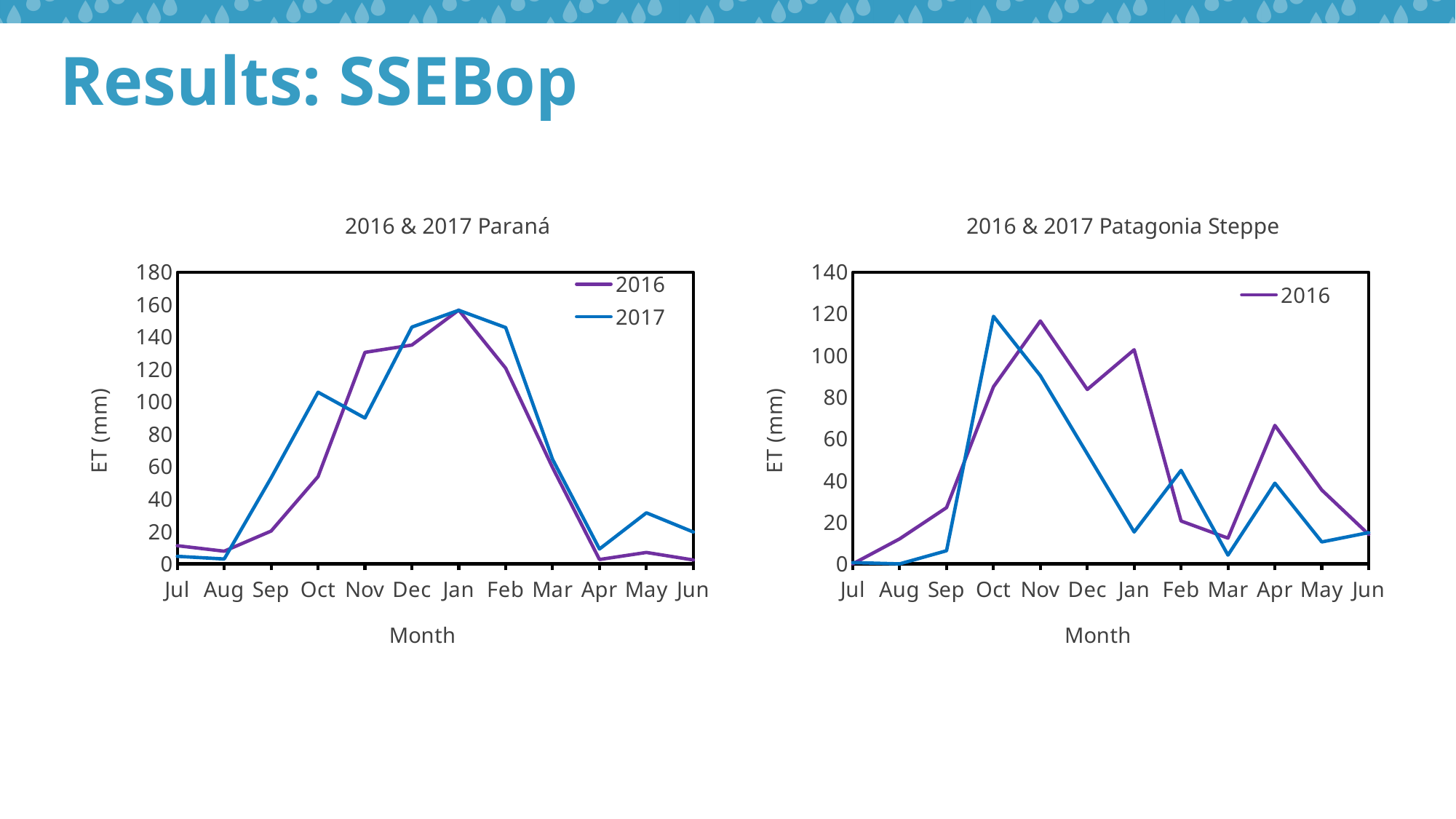
In the 2016 & 2017 Paraná chart, in which month does the 2016 line reach its highest value? Jan In the 2016 & 2017 Patagonia Steppe chart, is the 2017 value for Jan greater or less than 20? less In the 2016 & 2017 Paraná chart, does the 2016 line rise or fall from Jul to Jan? rise How many months are plotted along the x axis of the 2016 & 2017 Patagonia Steppe chart? 12 In the 2016 & 2017 Paraná chart, is the 2016 value for Oct greater or less than 60? less What kind of chart is the 2016 & 2017 Paraná chart? line chart In the 2016 & 2017 Paraná chart, is the 2017 value for Oct greater or less than 100? greater What is the y-axis label of the 2016 & 2017 Patagonia Steppe chart? ET (mm) In the 2016 & 2017 Patagonia Steppe chart, in which month does the 2016 line reach its highest value? Nov In the 2016 & 2017 Paraná chart, which series has the larger value in Nov, 2016 or 2017? 2016 How many series does the legend of the 2016 & 2017 Paraná chart list? 2 In the 2016 & 2017 Patagonia Steppe chart, which series has the larger value in Jan, 2016 or 2017? 2016